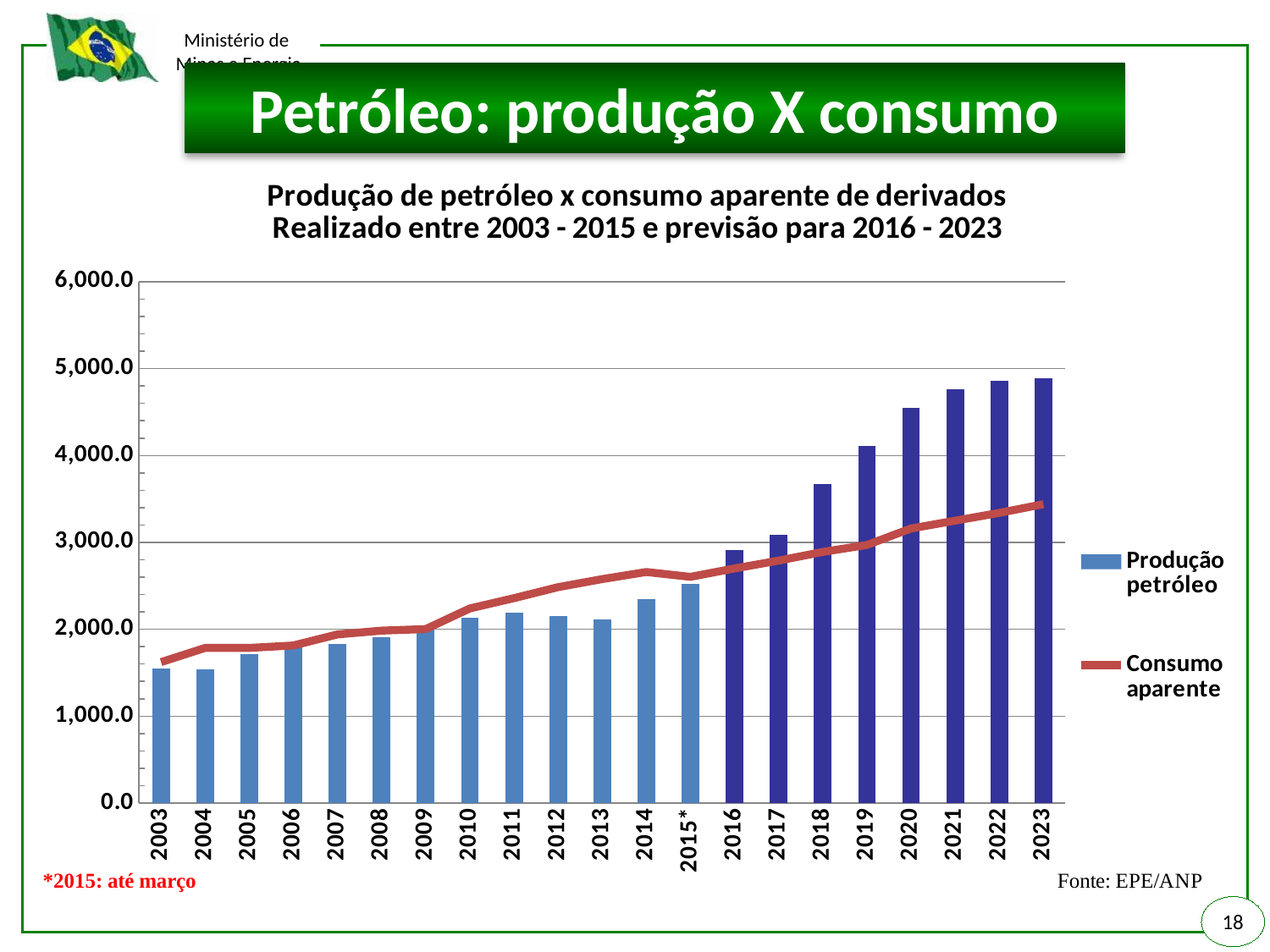
Do the Produção petróleo values generally rise or fall from 2003 to 2023? rise What are the two entries in the chart legend? Produção petróleo and Consumo aparente Is the Produção petróleo value for 2023 greater or less than 4,000.0? greater In 2018, which is larger: Produção petróleo or Consumo aparente? Produção petróleo What kind of chart is used to show Produção petróleo? bar chart Is the Consumo aparente value for 2003 greater or less than 2,000.0? less Is the Consumo aparente value for 2023 greater or less than 3,000.0? greater Which year has the highest Produção petróleo bar? 2023 In 2014, which is larger: Produção petróleo or Consumo aparente? Consumo aparente How many years are shown on the x axis? 21 How many series does the legend list? 2